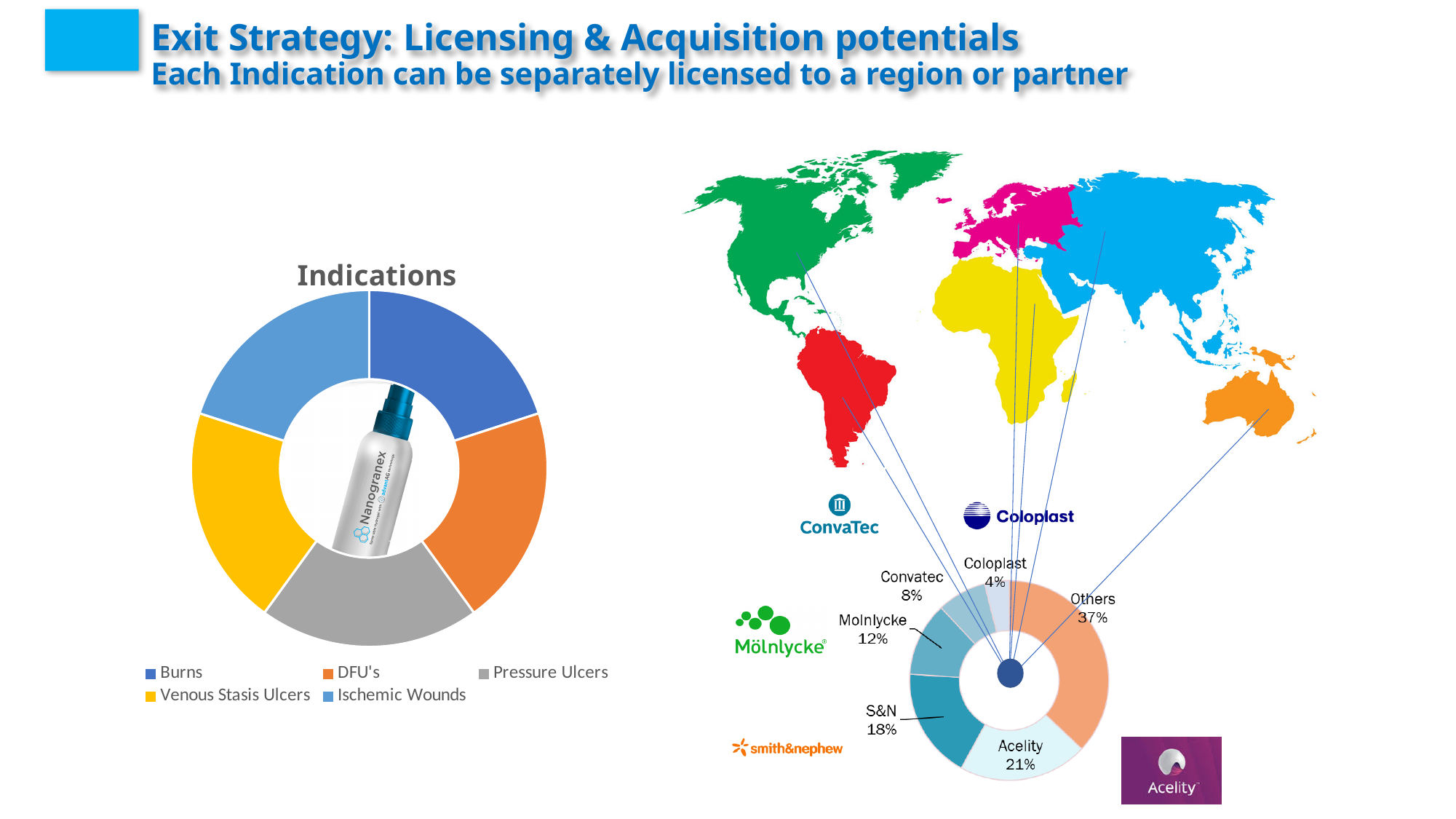
On the Indications chart, how many categories does the legend list? 5 On the market share doughnut chart at the bottom right, which is larger, Convatec or Molnlycke? Molnlycke On the market share doughnut chart at the bottom right, which segment has the smallest share? Coloplast On the market share doughnut chart at the bottom right, how many segments are labelled? 6 On the Indications chart, which category is shown in orange? DFU's On the market share doughnut chart at the bottom right, what is the value for Coloplast? 4% On the market share doughnut chart at the bottom right, what is the value for S&N? 18% What kind of chart is the Indications chart? Doughnut chart On the market share doughnut chart at the bottom right, what is the difference between Acelity and Molnlycke? 9% On the market share doughnut chart at the bottom right, what is the value for Acelity? 21% On the Indications chart, which colour represents Venous Stasis Ulcers? Yellow On the market share doughnut chart at the bottom right, which segment has the largest share? Others